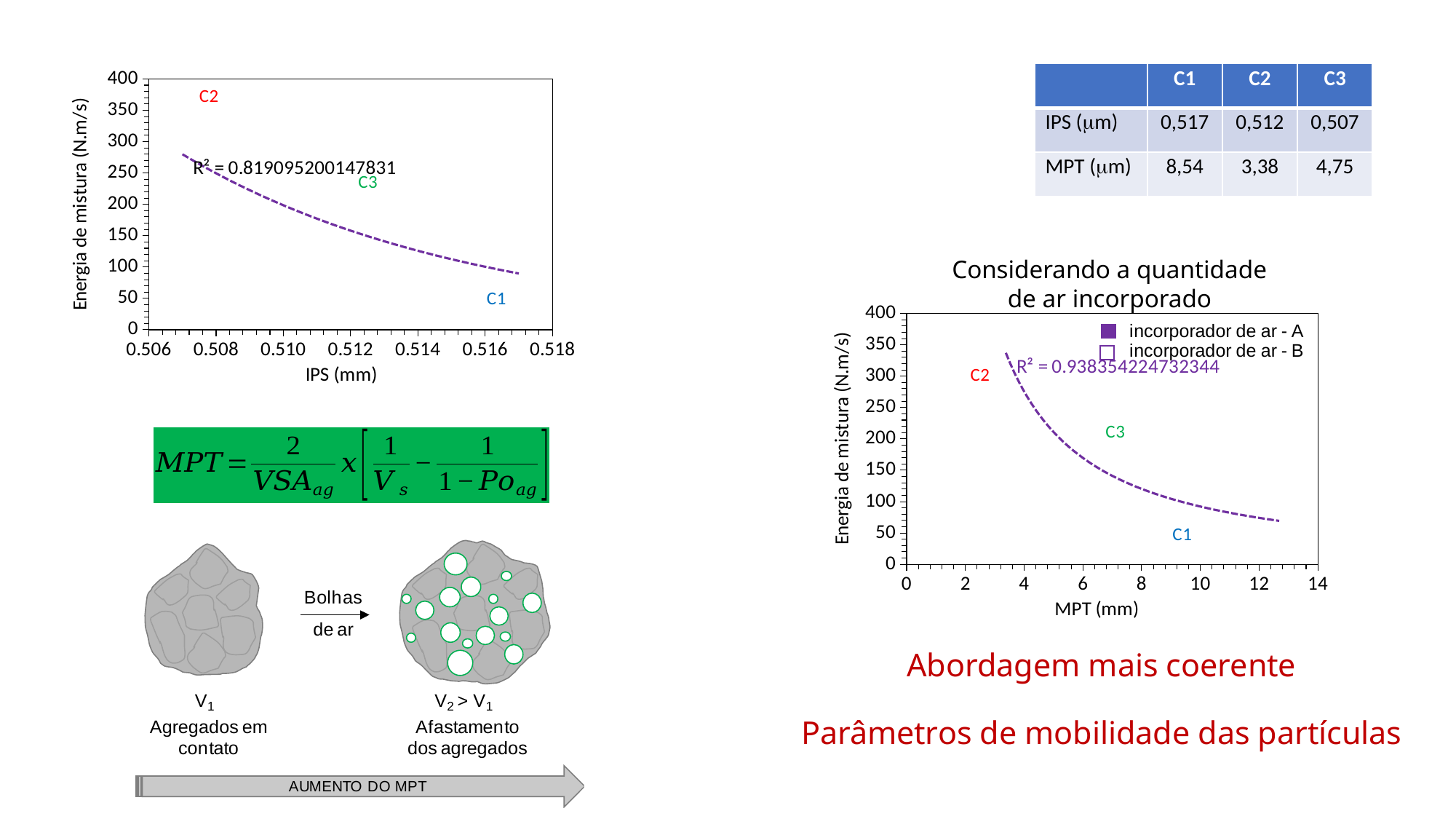
What kind of chart is the chart on the left of the slide (Energia de mistura vs IPS)? Scatter chart with a trendline How many labelled points (C1, C2, C3) are shown on the chart on the left (Energia de mistura vs IPS)? 3 In the chart on the left (Energia de mistura vs IPS), does the trendline rise or fall as IPS increases? Fall What is the y-axis title of the chart on the left (Energia de mistura vs IPS)? Energia de mistura (N.m/s) What R² value is printed on the chart on the left (Energia de mistura vs IPS)? 0.819095200147831 In the chart on the right (Considerando a quantidade de ar incorporado), how many series does the legend list? 2 Which of the two charts on the slide has the higher printed R² value? The chart on the right (Considerando a quantidade de ar incorporado) In the chart on the right (Considerando a quantidade de ar incorporado), does the trendline rise or fall as MPT increases? Fall What R² value is printed on the chart on the right (Considerando a quantidade de ar incorporado)? 0.938354224732344 What is the x-axis title of the chart on the right (Considerando a quantidade de ar incorporado)? MPT (mm) In the chart on the right (Considerando a quantidade de ar incorporado), what are the two legend entries? incorporador de ar - A; incorporador de ar - B